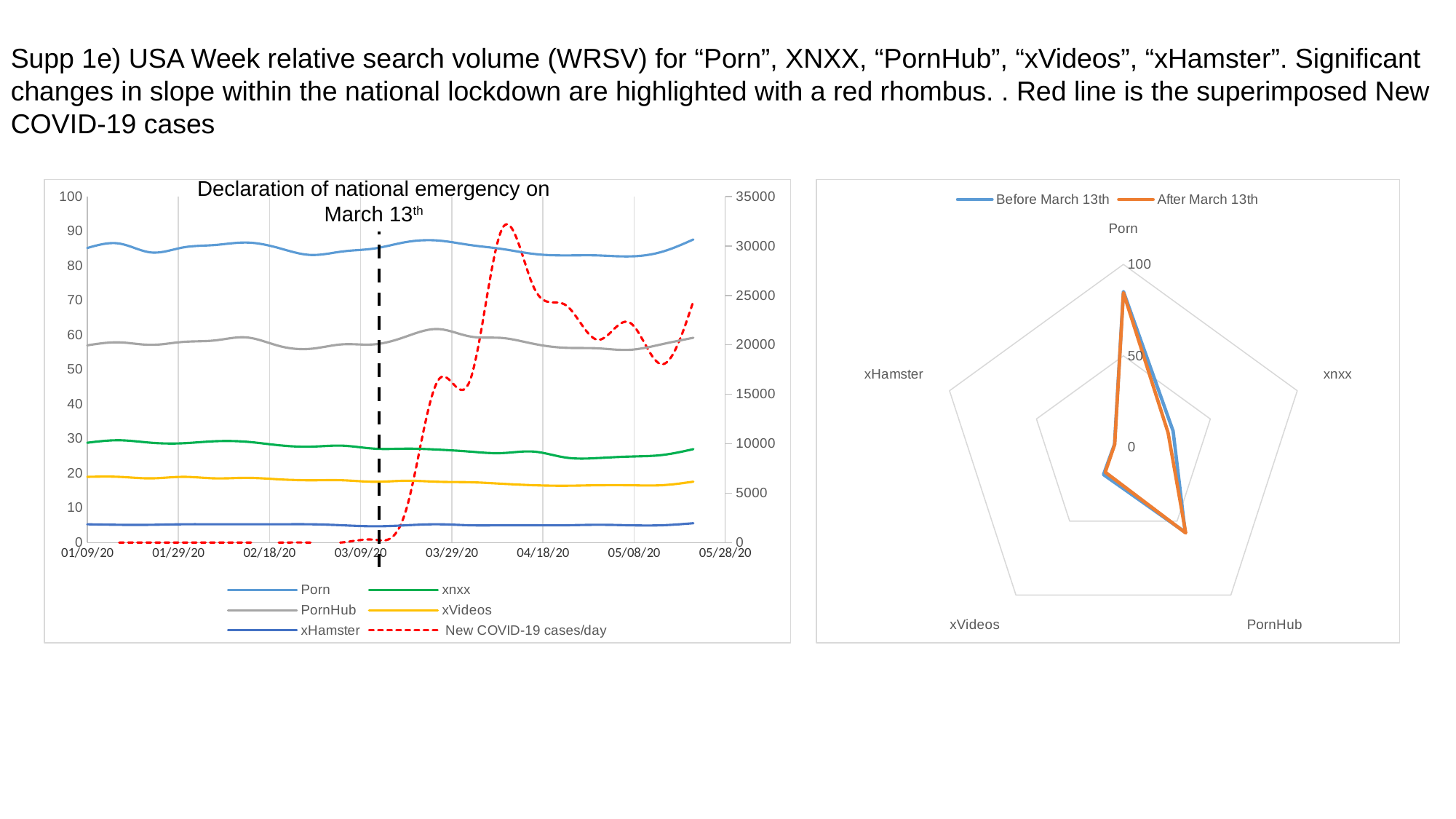
In the left chart, which is larger on 02/18/20, the WRSV for PornHub or for xVideos? PornHub In the left chart, do the New COVID-19 cases/day rise or fall between 03/09/20 and 03/29/20? rise In the left chart, is the WRSV for Porn on 01/09/20 greater or less than 80? greater In the right chart, which category has the highest value for both series? Porn What kind of chart is the right chart? radar chart In the left chart, is the WRSV for xnxx on 03/09/20 greater or less than 40? less How many categories are plotted on the right radar chart? 5 In the left chart, which search term has the highest WRSV throughout the period? Porn In the left chart, which search term has the lowest WRSV throughout the period? xHamster What kind of chart is the left chart? line chart How many series does the legend of the left chart list? 6 How many series does the legend of the right chart list? 2